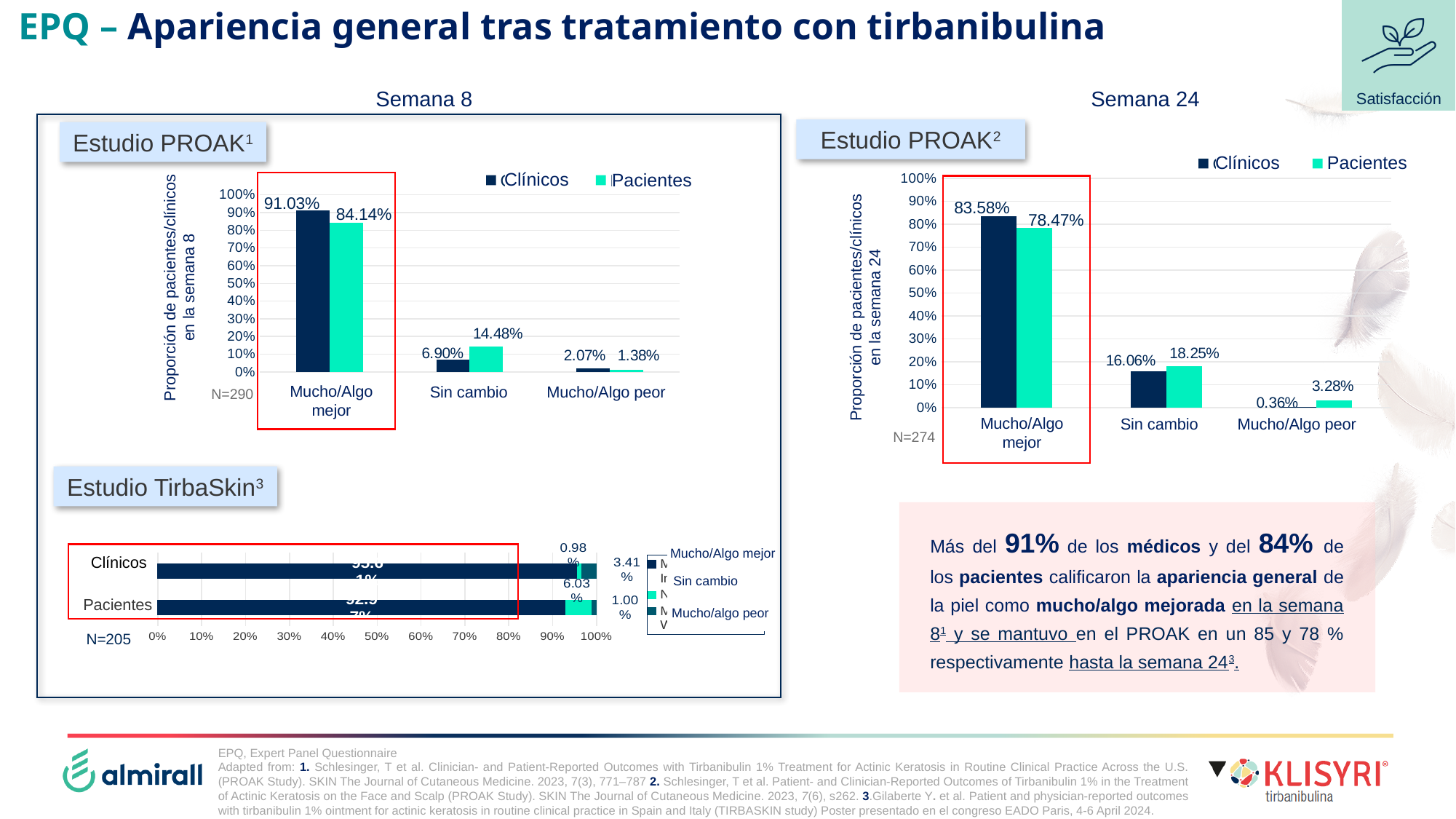
In the Semana 24 Estudio PROAK chart, what is the value for Pacientes in the Mucho/Algo mejor category? 78.47% In the Semana 24 Estudio PROAK chart, which category has the highest value for Clínicos? Mucho/Algo mejor In the Semana 8 Estudio PROAK chart, which category has the lowest value for Pacientes? Mucho/Algo peor In the Semana 8 Estudio PROAK chart, what is the difference between the Clínicos and Pacientes values for Mucho/Algo mejor? 6.89 percentage points What kind of chart is the Estudio TirbaSkin chart at the bottom left of the slide? Bar chart In the Semana 8 Estudio PROAK chart, what is the value for Pacientes in the Sin cambio category? 14.48% How many series does the legend of the Semana 24 Estudio PROAK chart list? 2 In the Semana 24 Estudio PROAK chart, how much higher is the Pacientes value than the Clínicos value for Sin cambio? 2.19 percentage points How many categories are shown on the x axis of the Semana 8 Estudio PROAK chart? 3 In the Semana 24 Estudio PROAK chart, what is the value for Clínicos in the Mucho/Algo peor category? 0.36% In the Semana 8 Estudio PROAK chart, which series has the higher value for Sin cambio, Clínicos or Pacientes? Pacientes In the Semana 8 Estudio PROAK chart, what is the value for Clínicos in the Mucho/Algo mejor category? 91.03%